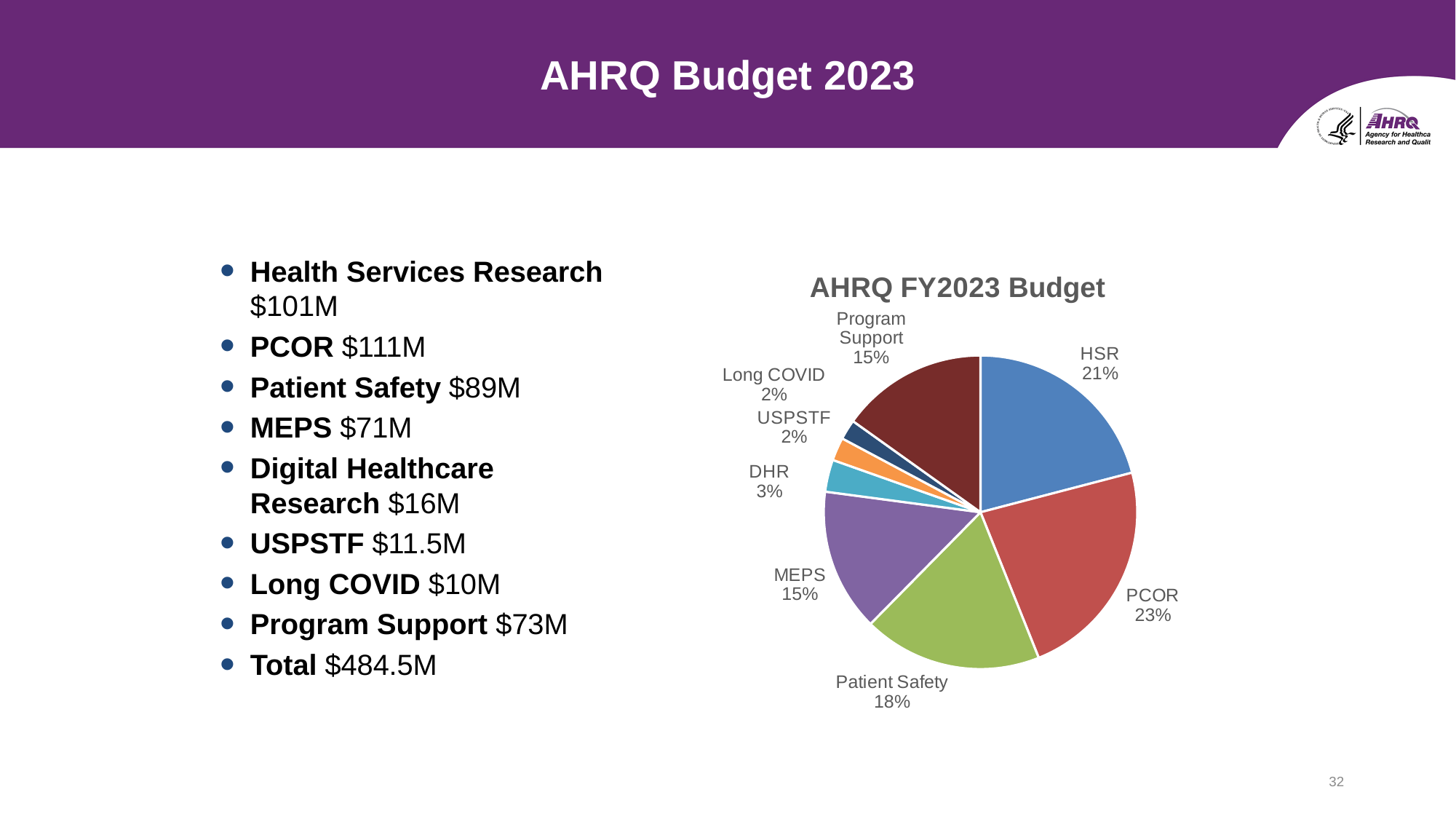
What is the title of the chart? AHRQ FY2023 Budget What type of chart is shown on the slide? Pie chart How many categories are shown in the pie chart? 8 What is the combined percentage of MEPS and Program Support in the pie chart? 30% Which category has the largest slice in the pie chart? PCOR What percentage is shown for HSR in the pie chart? 21% What percentage is shown for Patient Safety in the pie chart? 18% What share of the AHRQ FY2023 Budget pie chart does PCOR represent? 23% What is the difference in percentage points between PCOR and HSR in the pie chart? 2 What percentage is shown for DHR in the pie chart? 3% Which category has the smallest share in the pie chart, Long COVID or DHR? Long COVID Which is larger in the pie chart, Patient Safety or MEPS? Patient Safety